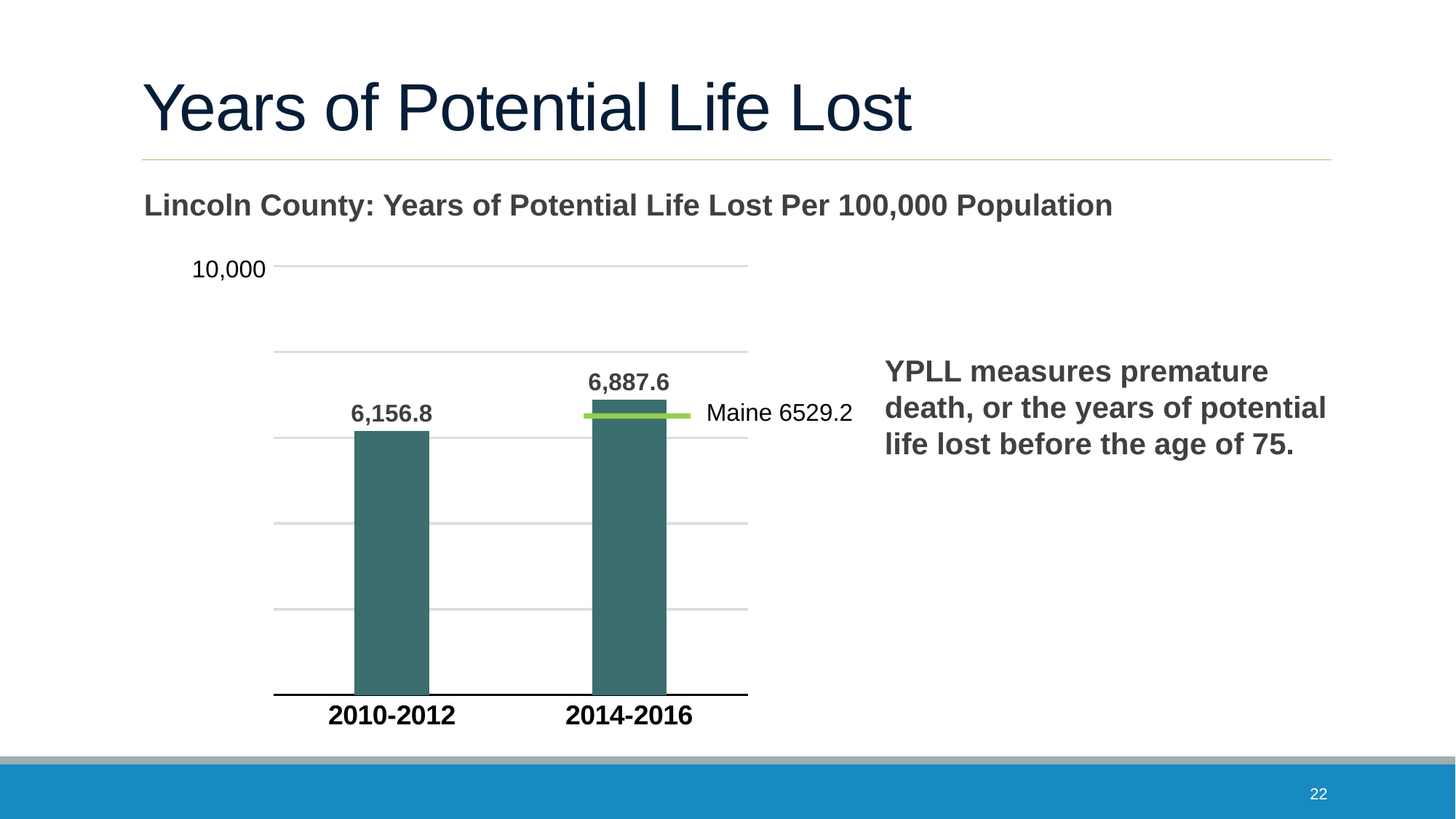
Is the value for 2014-2016 larger or smaller than the Maine value of 6529.2? larger Do the values rise or fall from 2010-2012 to 2014-2016? rise What is the difference between the 2014-2016 value and the 2010-2012 value? 730.8 What kind of chart is this? bar chart Is the value for 2010-2012 greater or less than 10,000? less What is the title of the chart? Lincoln County: Years of Potential Life Lost Per 100,000 Population Which period has the higher value? 2014-2016 How many periods are shown on the x axis? 2 Which period has the lower value? 2010-2012 What is the value for 2010-2012? 6,156.8 What is the value for 2014-2016? 6,887.6 What is the Maine value shown by the reference line? 6529.2